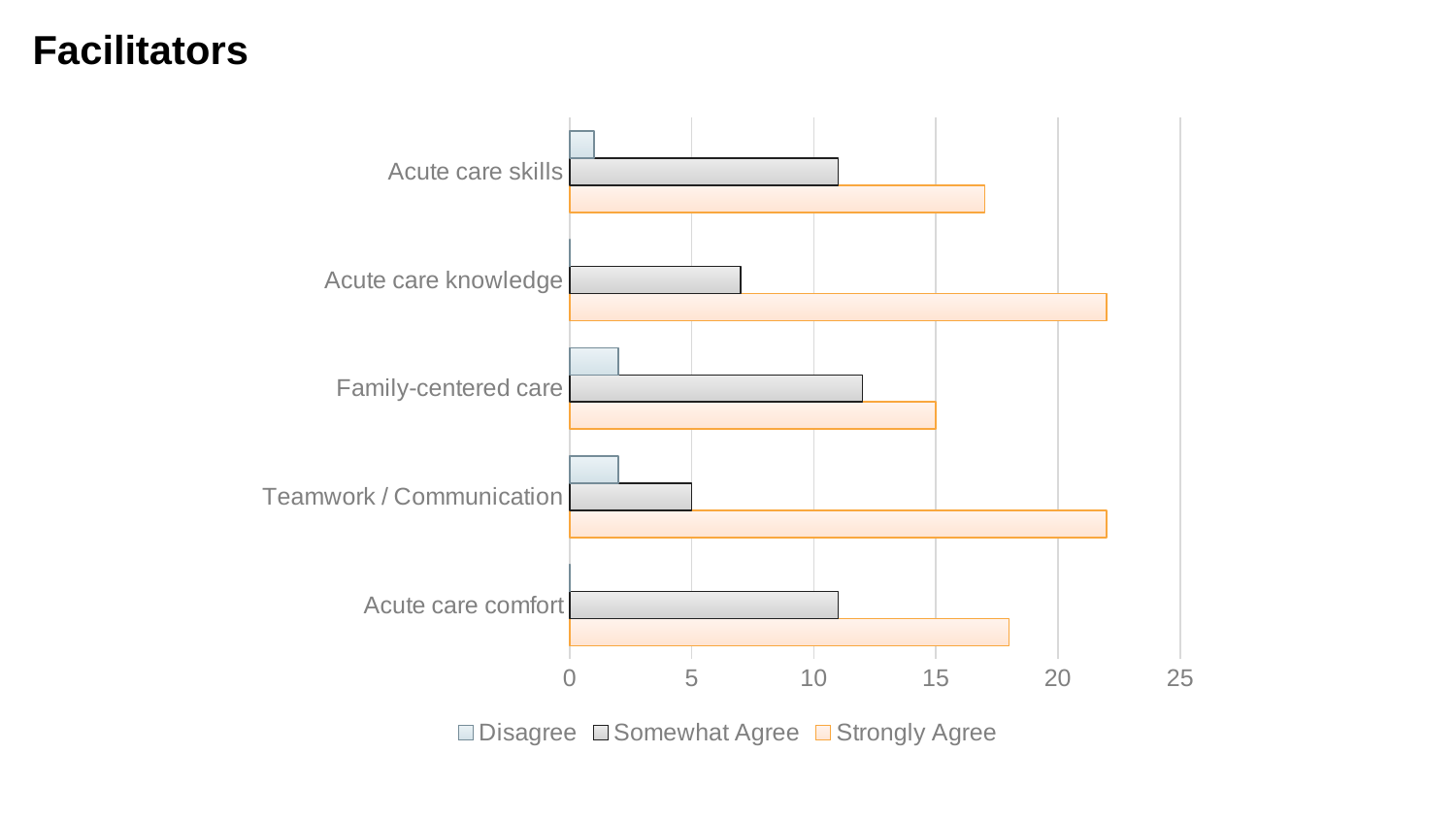
What is the Strongly Agree value for Family-centered care? 15 What kind of chart is shown on the slide? bar chart Is the Strongly Agree value for Acute care knowledge greater or less than 20? greater How many series does the legend list? 3 Which is larger: the Somewhat Agree value for Acute care skills or for Acute care knowledge? Acute care skills Which category has the lowest Somewhat Agree value? Teamwork / Communication Which is larger: the Strongly Agree value for Acute care comfort or for Family-centered care? Acute care comfort What are the three series listed in the legend? Disagree, Somewhat Agree, Strongly Agree What is the Somewhat Agree value for Teamwork / Communication? 5 How many categories are shown on the chart? 5 Is the Somewhat Agree value for Acute care knowledge greater or less than 10? less Which category has the lowest Strongly Agree value? Family-centered care